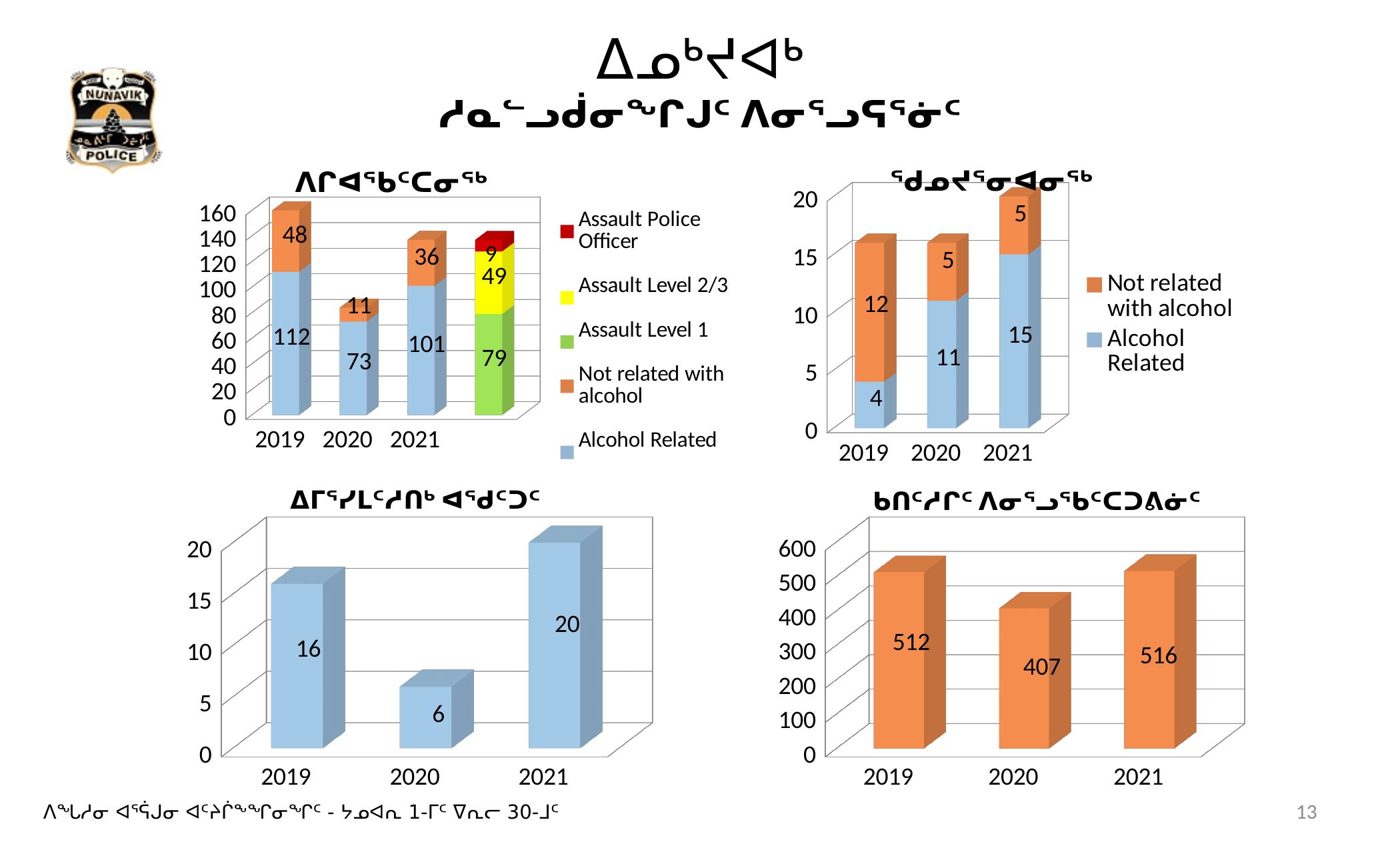
In the top-right chart, which year has the lowest Alcohol Related value? 2019 In the top-right chart, what is the total of the stacked bar for 2019? 16 In the top-left chart, what is the Not related with alcohol value for 2021? 36 In the bottom-left chart, which year has the highest value? 2021 In the top-left chart, what is the Alcohol Related value for 2019? 112 In the bottom-right chart, which is larger, the value for 2019 or the value for 2021? 2021 In the top-left chart, what is the total of the stacked bar for 2020? 84 What kind of chart is the bottom-right chart? bar chart In the bottom-right chart, what is the difference between the values for 2019 and 2020? 105 In the bottom-left chart, what is the value for 2020? 6 How many series does the legend of the top-left chart list? 5 In the top-right chart, what is the Alcohol Related value for 2021? 15